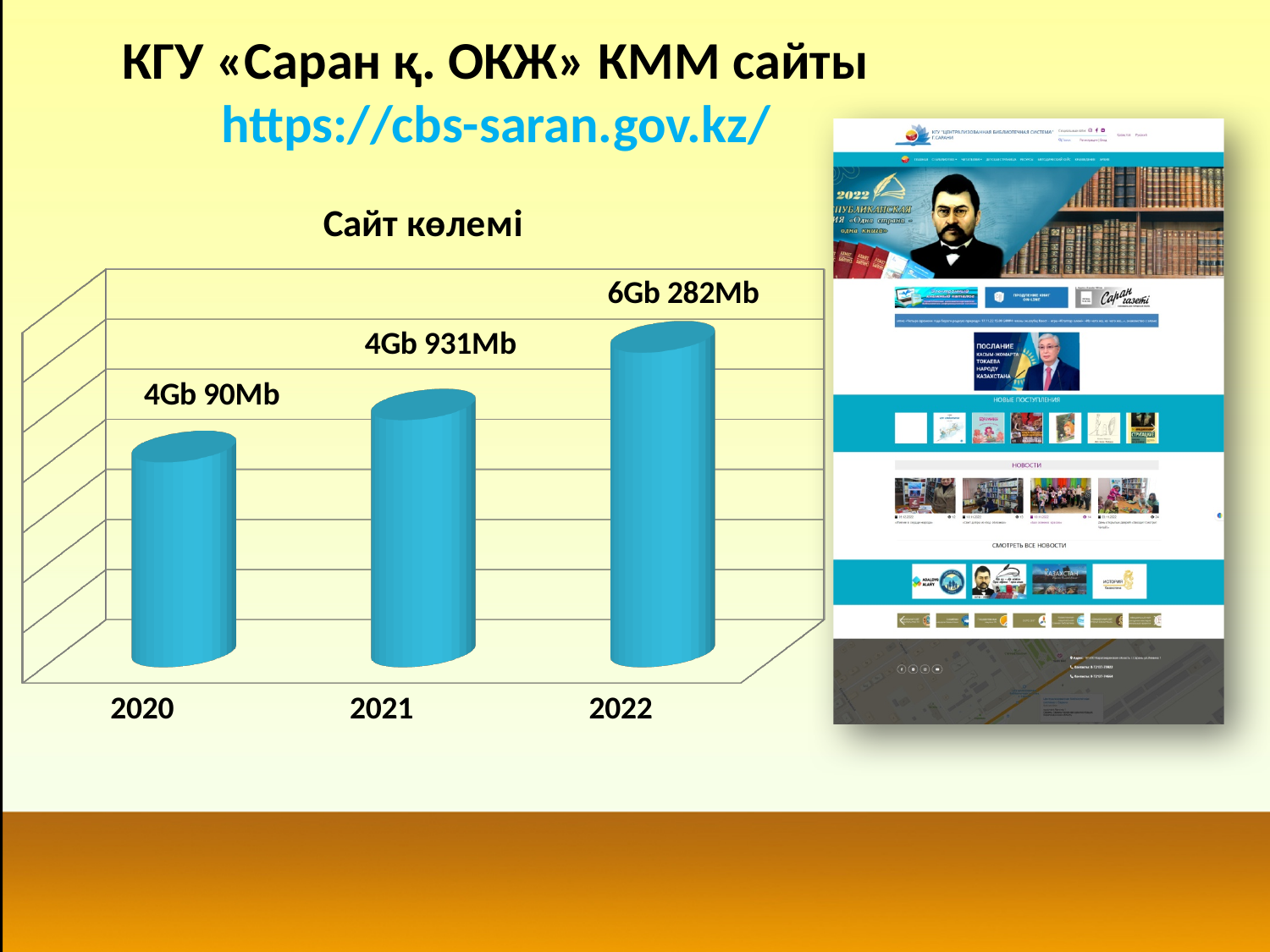
Which year has the larger site size, 2020 or 2021? 2021 What is the site size shown for 2021? 4Gb 931Mb Which year has the largest site size? 2022 What is the title of the chart? Сайт көлемі By how much did the site size grow from 2020 to 2021? 841Mb What is the site size shown for 2020? 4Gb 90Mb What kind of chart is shown on the slide? bar chart Which year has the larger site size, 2021 or 2022? 2022 How many years are shown on the chart? 3 Which year has the smallest site size? 2020 What is the site size shown for 2022? 6Gb 282Mb Does the site size rise or fall from 2020 to 2022? rise